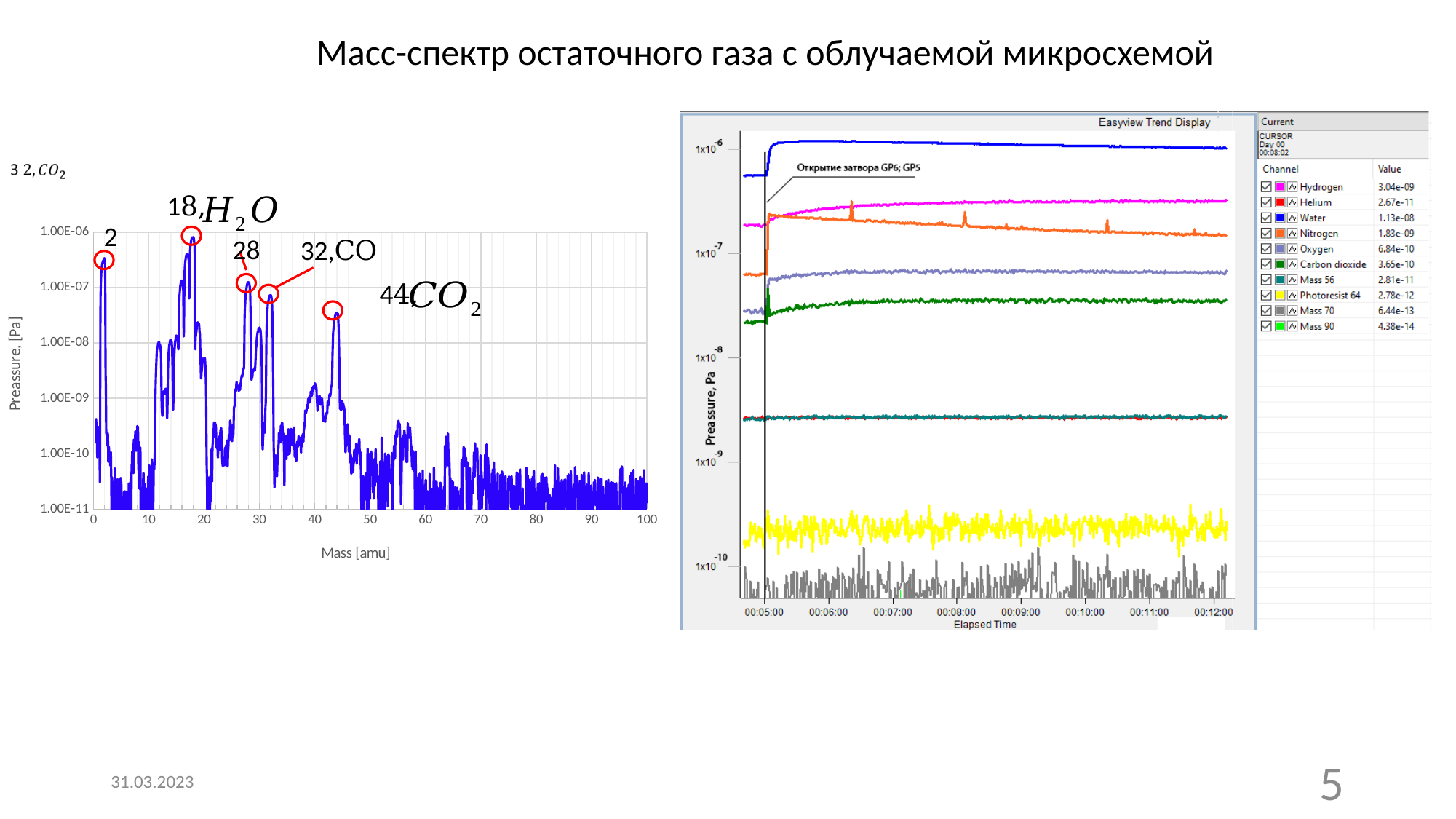
On the left chart, is the peak at mass 44 greater or less than 1.00E-07 Pa? less On the right chart (Easyview Trend Display), which channel has the highest value in the legend table? Water On the left chart, which peak is higher: the one at mass 28 or the one at mass 44? mass 28 On the left chart, is the peak at mass 2 greater or less than 1.00E-07 Pa? greater On the right chart (Easyview Trend Display), what is the value shown for Water? 1.13e-08 What kind of chart is the left chart (the mass spectrum)? line chart On the right chart (Easyview Trend Display), what is the value shown for Carbon dioxide? 3.65e-10 On the right chart (Easyview Trend Display), which channel has the lowest value in the legend table? Mass 90 On the right chart (Easyview Trend Display), how many channels does the legend list? 10 On the left chart, what is the label of the x axis? Mass [amu] On the right chart (Easyview Trend Display), which has the larger value: Hydrogen or Nitrogen? Hydrogen On the left chart, at which annotated mass is the highest peak? 18